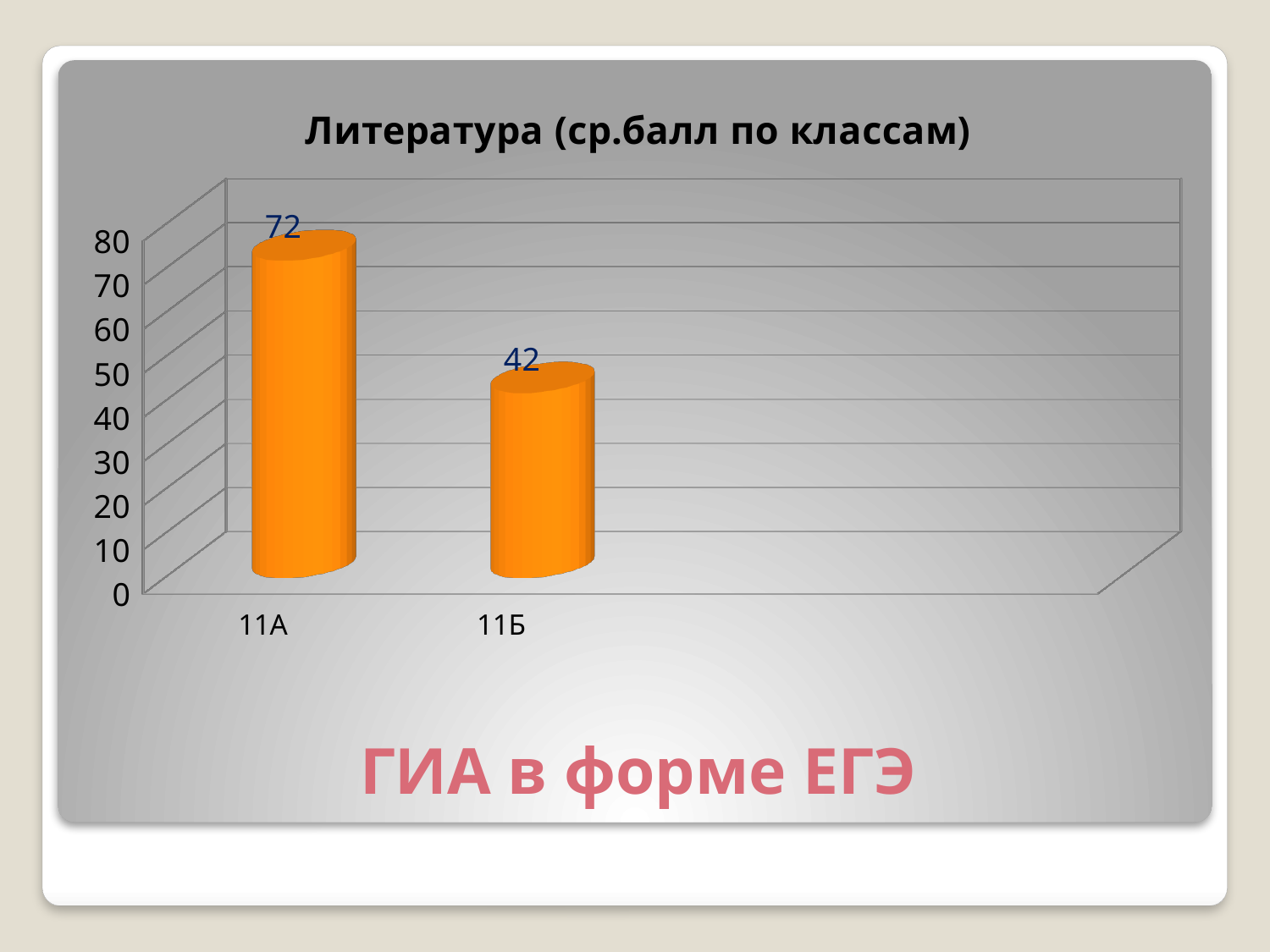
What is the value for 11А? 72 What kind of chart is shown on the slide? bar chart Which class has the lowest average score? 11Б What is the difference between the values for 11А and 11Б? 30 Is the value for 11Б greater or less than 50? less Which is larger, the value for 11А or the value for 11Б? 11А What colour are the bars on the chart? orange Which class has the highest average score? 11А What is the title of the chart? Литература (ср.балл по классам) How many classes are shown on the chart? 2 Is the value for 11А greater or less than 60? greater What is the value for 11Б? 42